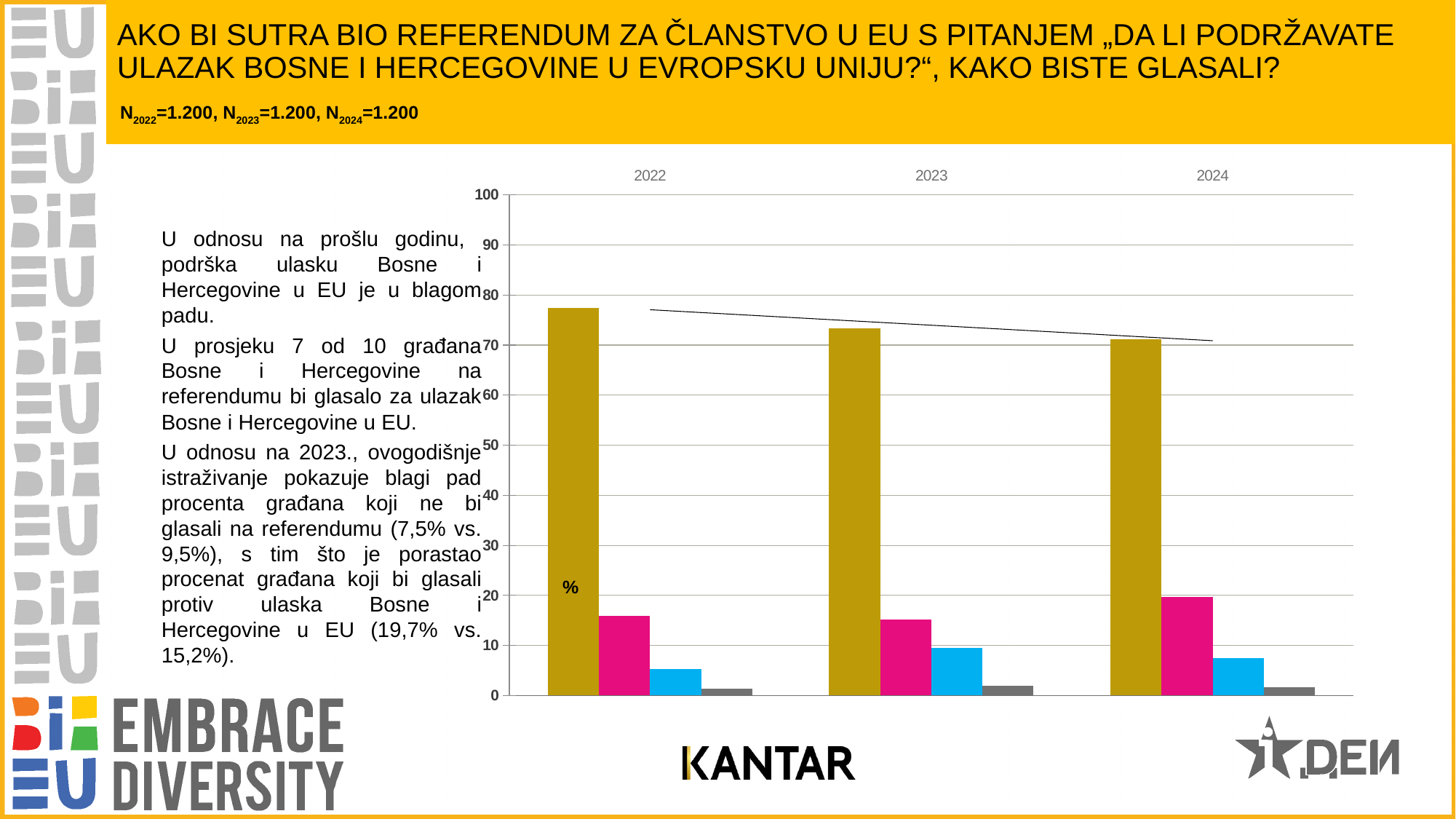
How many bars are plotted for each year in the chart? 4 In which year is the gold bar the highest? 2022 Which year has the larger pink bar, 2023 or 2024? 2024 What is the highest value shown on the vertical axis of the chart? 100 Do the gold (tallest) bars rise or fall from 2022 to 2024? fall Is the value of the gold bar for 2024 greater or less than 80? less How many years (categories) are shown on the x axis of the chart? 3 Is the value of the gold bar for 2022 greater or less than 70? greater What kind of chart is shown on the slide? bar chart Is the value of the blue bar for 2023 greater or less than 20? less In which year is the gold bar the lowest? 2024